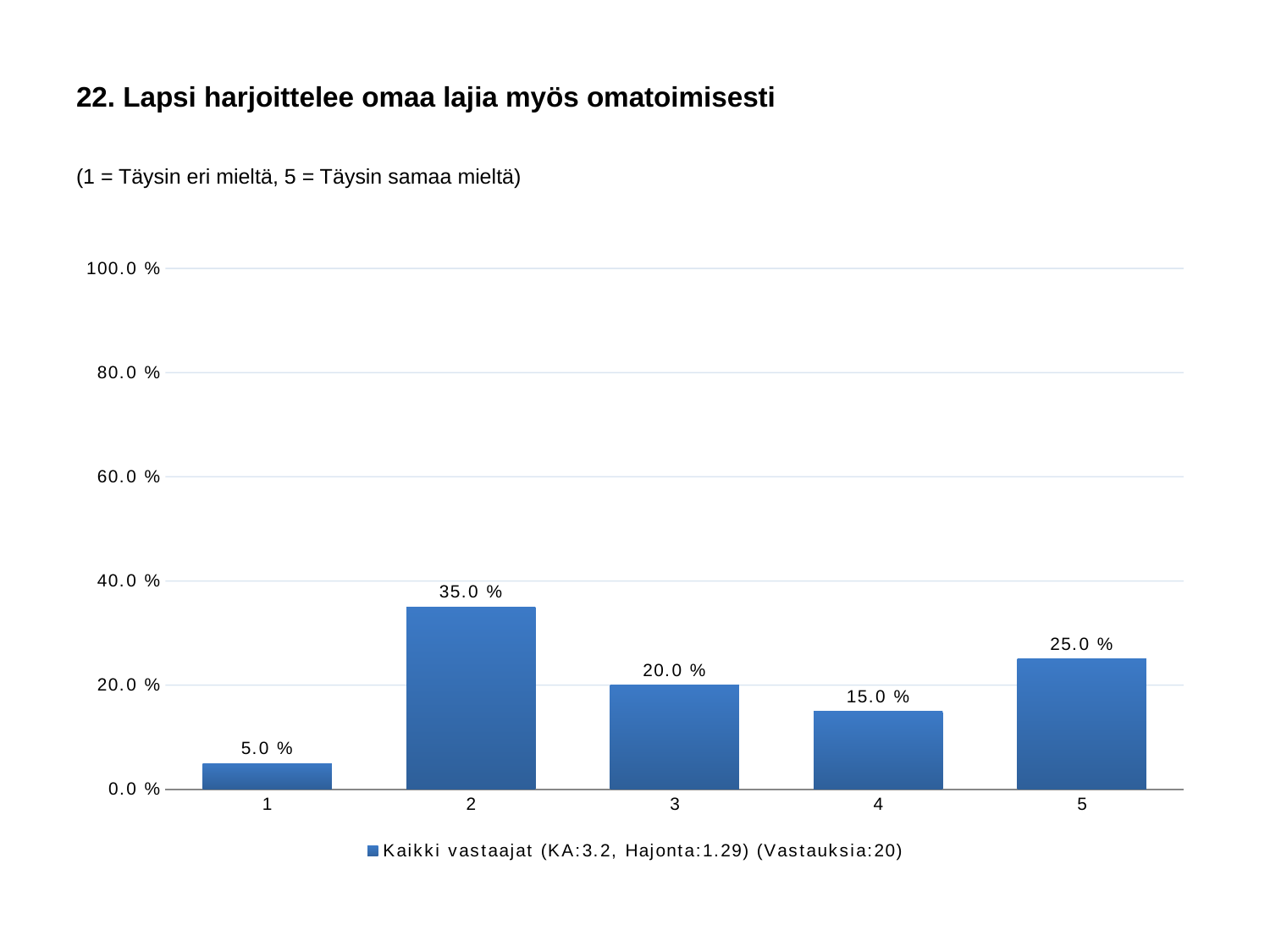
What is the value for category 2? 35.0 % Is the value for category 2 greater or less than 40.0 %? less What kind of chart is shown on the slide? bar chart Which category has the highest value? 2 Which is larger, the value for category 4 or the value for category 5? 5 What is the legend entry for the series? Kaikki vastaajat (KA:3.2, Hajonta:1.29) (Vastauksia:20) What is the value for category 5? 25.0 % How many series does the legend list? 1 How many categories are shown on the x axis? 5 Which category has the lowest value? 1 What is the difference between the values for category 2 and category 3? 15.0 % What is the value for category 1? 5.0 %